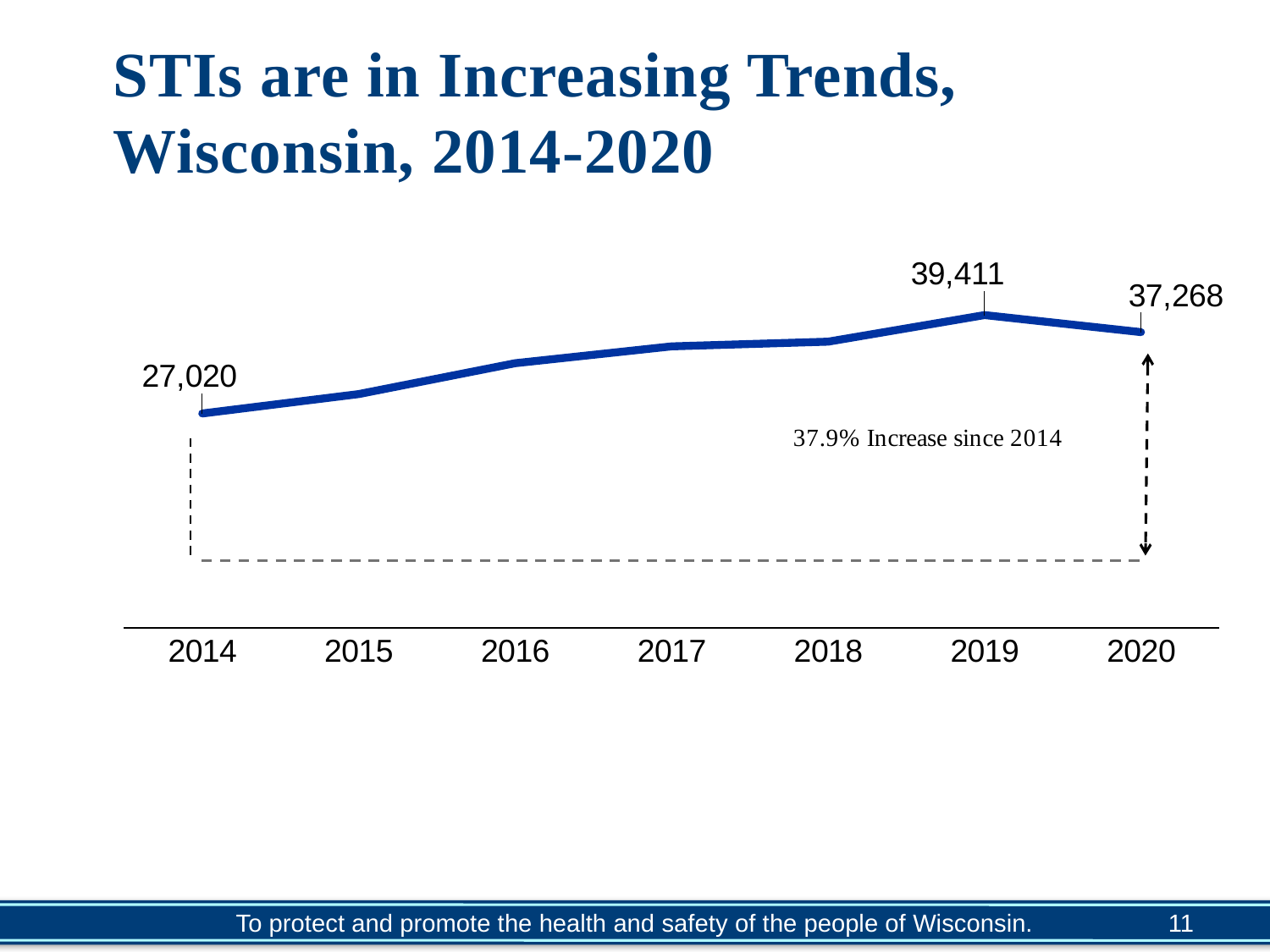
By how much did the value increase from 2014 to 2020? 10,248 What is the value for 2020? 37,268 What is the value for 2019? 39,411 Which is larger, the value for 2019 or the value for 2020? 2019 Which year has the highest value? 2019 How many years are shown on the x axis? 7 What is the difference between the values for 2019 and 2020? 2,143 Do the values rise or fall from 2014 to 2019? Rise Which year has the lowest value? 2014 What percentage increase since 2014 is annotated on the chart? 37.9% What kind of chart is shown on the slide? Line chart What is the value for 2014? 27,020